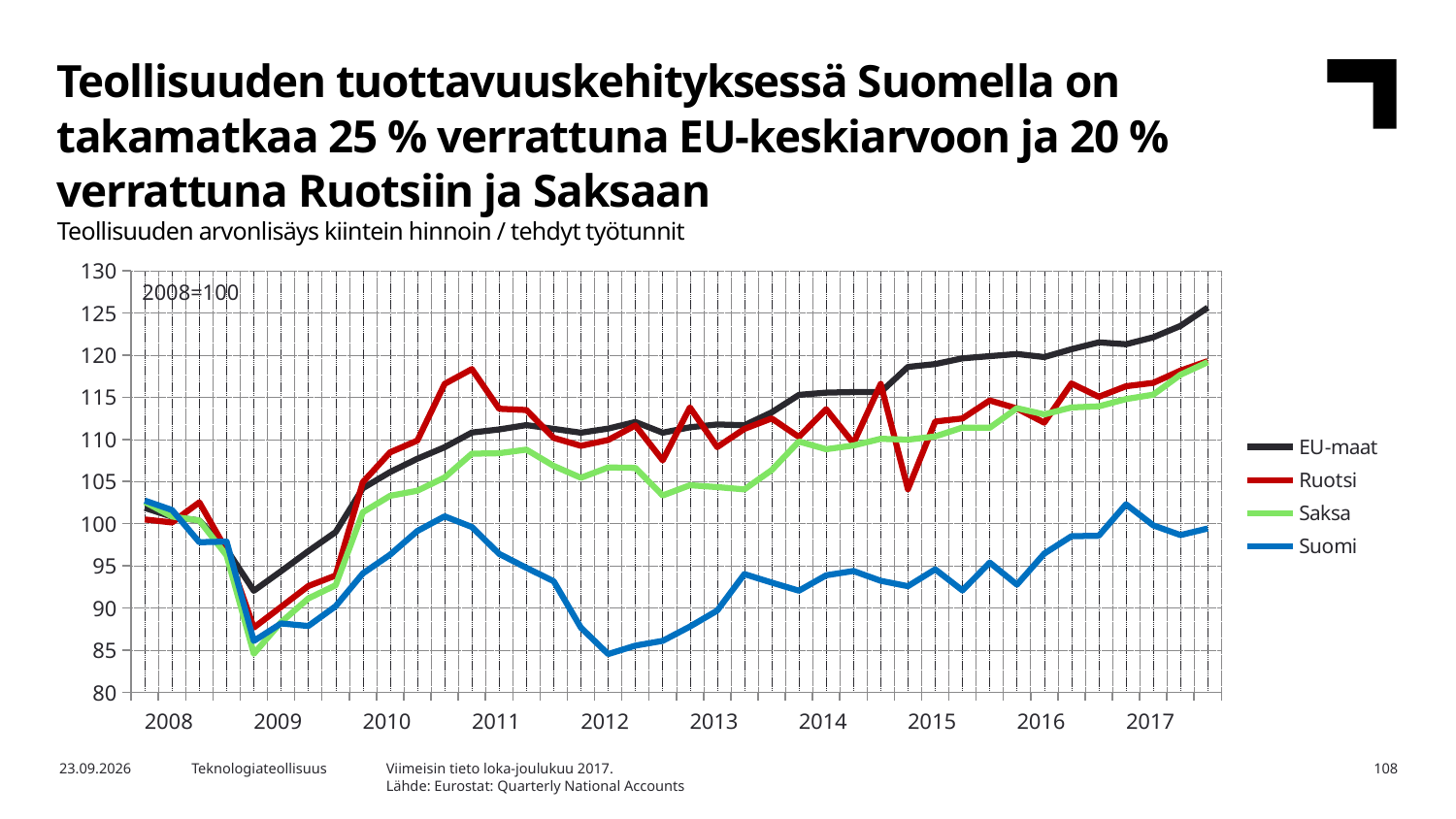
Is the lowest value for Suomi in 2012 greater or less than 90? less What base year and index value is noted on the chart? 2008=100 Which series has the lowest value at the end of 2017? Suomi Is the peak value for Ruotsi in 2010 greater or less than 115? greater Is the value for EU-maat at the end of 2017 greater or less than 120? greater Which series has the highest value at the end of 2017? EU-maat What kind of chart is shown on the slide? line chart Which series are listed in the legend? EU-maat, Ruotsi, Saksa, Suomi How many series does the legend list? 4 At the end of 2017, which is larger: the value for EU-maat or the value for Suomi? EU-maat Does the EU-maat series rise or fall from 2010 to 2017? rise